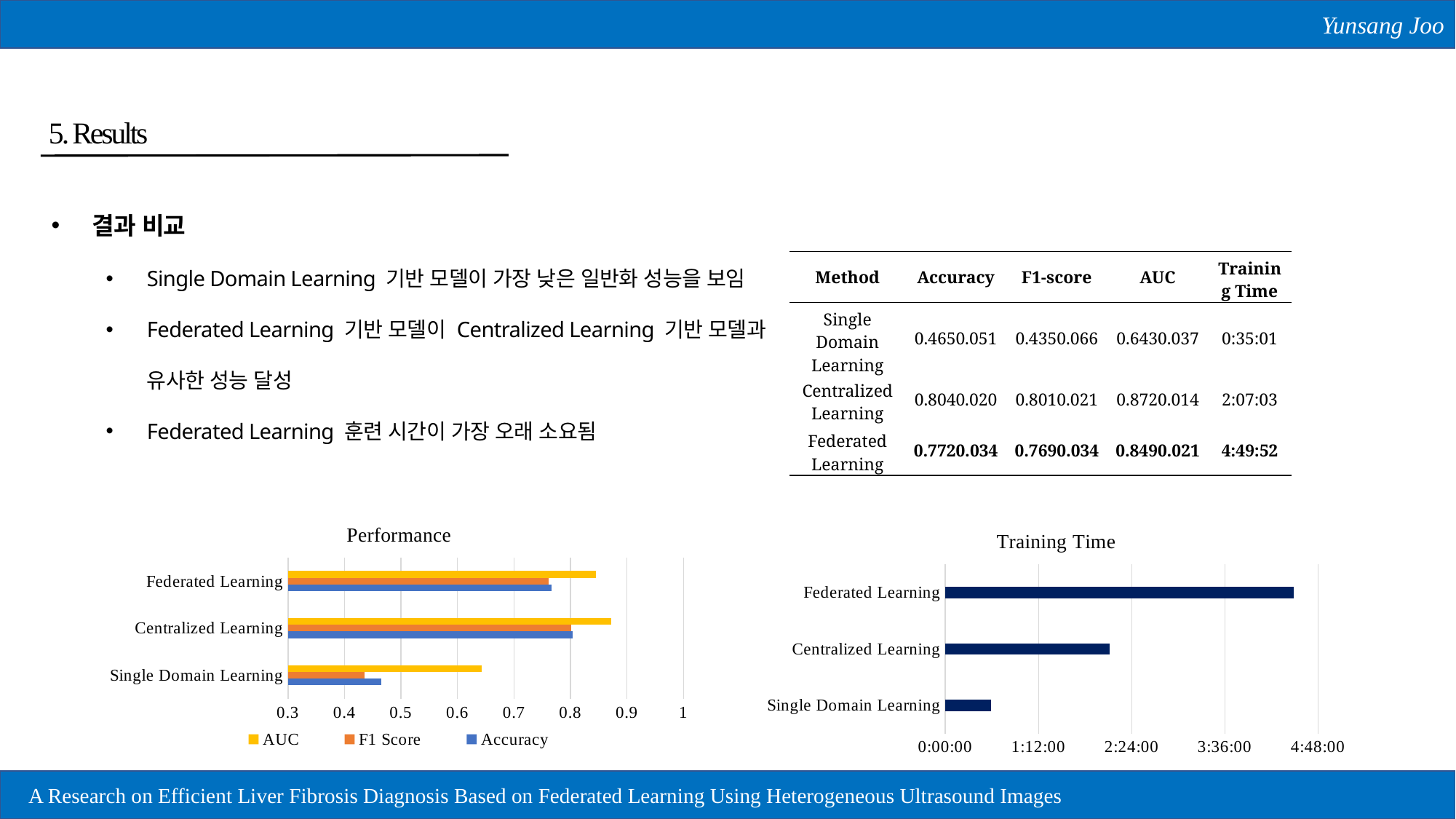
How many series does the legend of the Performance chart list? 3 What kind of chart is the Performance chart? bar chart How many categories are shown on the Performance chart? 3 What are the legend entries of the Performance chart? AUC, F1 Score, Accuracy On the Performance chart, which category has the lowest AUC? Single Domain Learning On the Training Time chart, is the value for Centralized Learning greater or less than 2:24:00? less On the Performance chart, is the AUC value for Centralized Learning greater or less than 0.8? greater On the Performance chart, which is larger: the AUC for Federated Learning or the AUC for Single Domain Learning? Federated Learning On the Performance chart, is the Accuracy value for Single Domain Learning greater or less than 0.5? less On the Training Time chart, which category has the longest training time? Federated Learning On the Training Time chart, which category has the shortest training time? Single Domain Learning